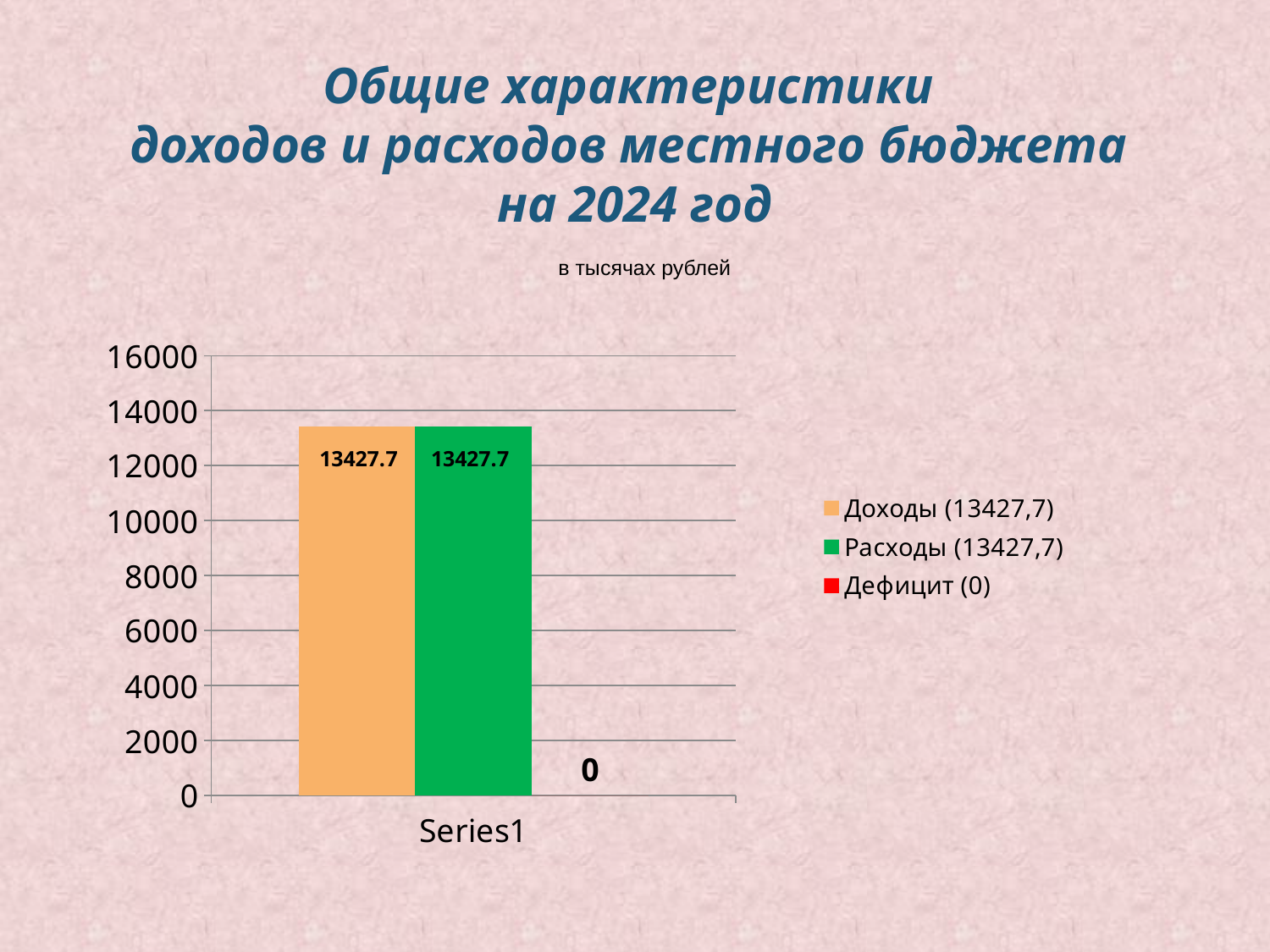
What unit is stated below the slide title for the chart values? в тысячах рублей What type of chart is shown on the slide? bar chart Is the value for Доходы greater or less than 12000? greater What is the difference between the Доходы value and the Дефицит value? 13427.7 Which series has the lowest value? Дефицит What is the value of the Доходы bar? 13427.7 How many series does the legend list? 3 What is the difference between the Доходы and Расходы values? 0 What is the value shown for Дефицит? 0 What is the category label shown on the x axis? Series1 What is the value of the Расходы bar? 13427.7 Is the value for Расходы greater or less than 14000? less